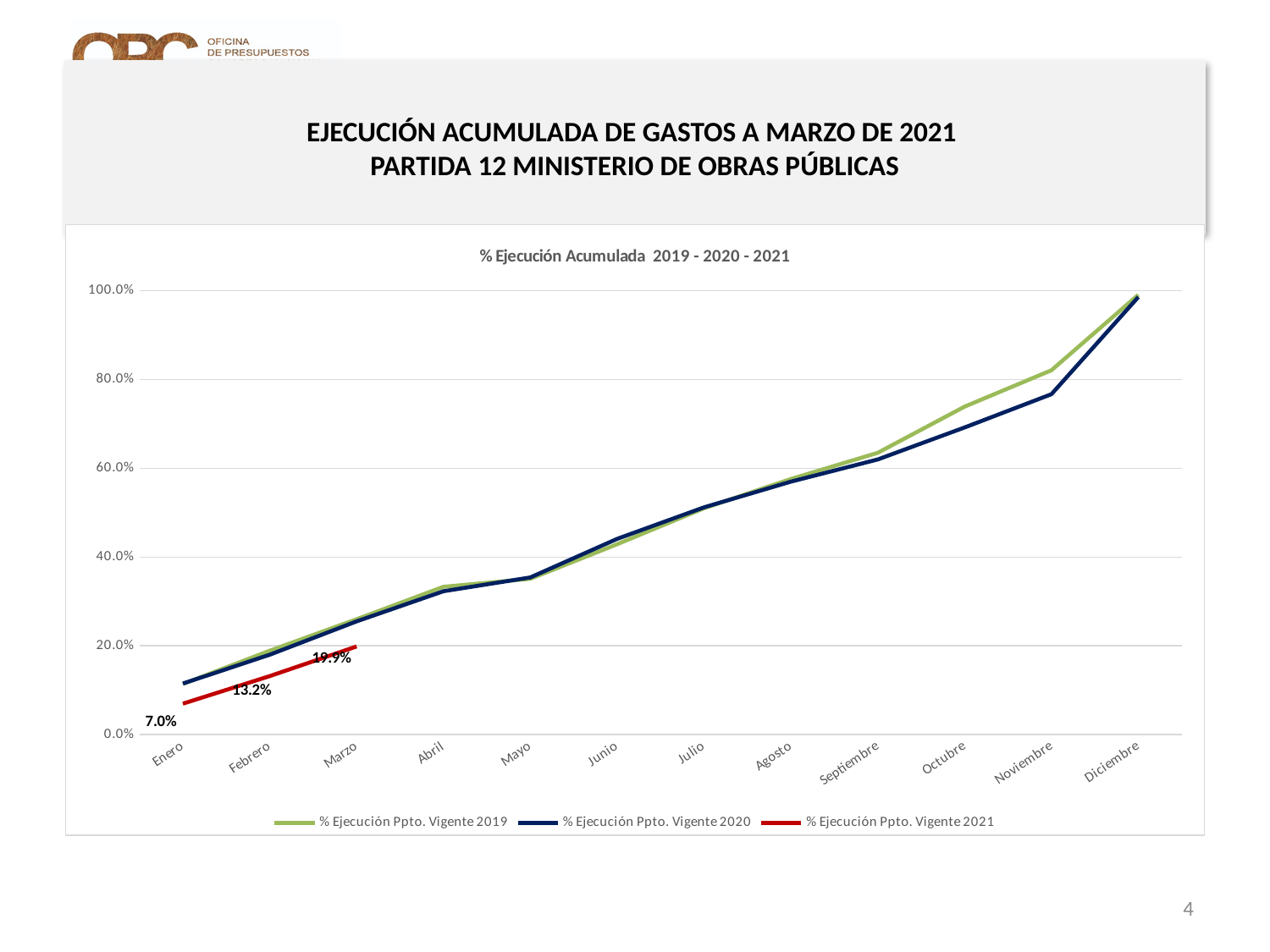
How many months are shown on the x axis? 12 In Noviembre, which series is higher: % Ejecución Ppto. Vigente 2019 or % Ejecución Ppto. Vigente 2020? % Ejecución Ppto. Vigente 2019 What kind of chart is shown? Line chart Which month has the highest value in the % Ejecución Ppto. Vigente 2021 series? Marzo What is the difference between the Marzo and Enero values of the % Ejecución Ppto. Vigente 2021 series? 12.9% What is the value for Febrero in the % Ejecución Ppto. Vigente 2021 series? 13.2% What is the title of the chart? % Ejecución Acumulada 2019 - 2020 - 2021 Do the values of the % Ejecución Ppto. Vigente 2019 series rise or fall from Enero to Diciembre? Rise How many series does the legend list? 3 What is the value for Marzo in the % Ejecución Ppto. Vigente 2021 series? 19.9% What is the value for Enero in the % Ejecución Ppto. Vigente 2021 series? 7.0% Is the Diciembre value for % Ejecución Ppto. Vigente 2019 greater or less than 80.0%? greater